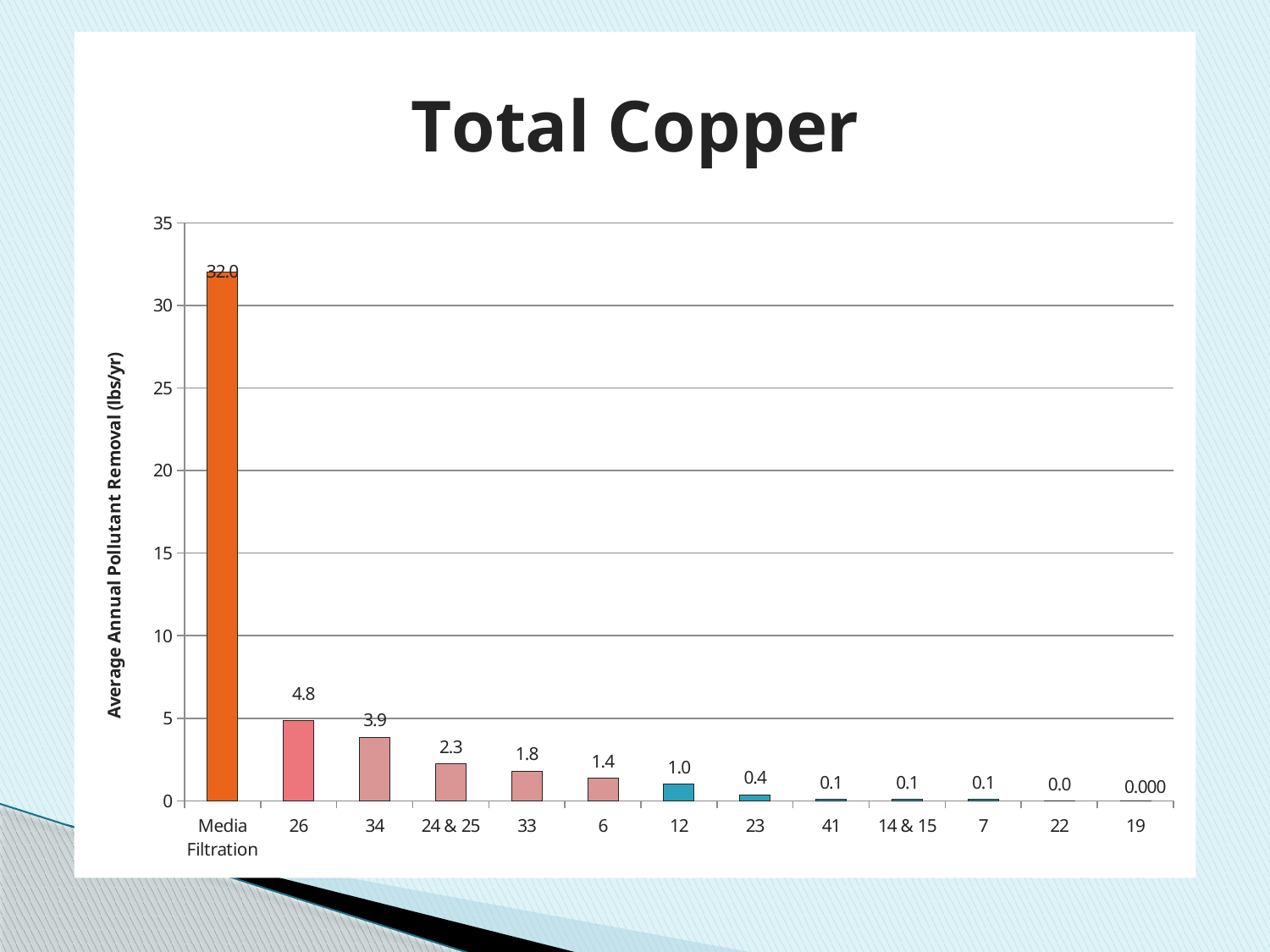
What is the label of the vertical axis? Average Annual Pollutant Removal (lbs/yr) Which category has the highest value? Media Filtration Which is larger, the value for category 33 or the value for category 6? 33 What kind of chart is shown? Bar chart What is the difference between the values for Media Filtration and category 26? 27.2 What is the value for category 24 & 25? 2.3 What is the value for Media Filtration? 32.0 What is the difference between the values for category 26 and category 34? 0.9 How many categories are shown on the x axis? 13 What is the value for category 12? 1.0 What is the value for category 26? 4.8 What is the value for category 23? 0.4